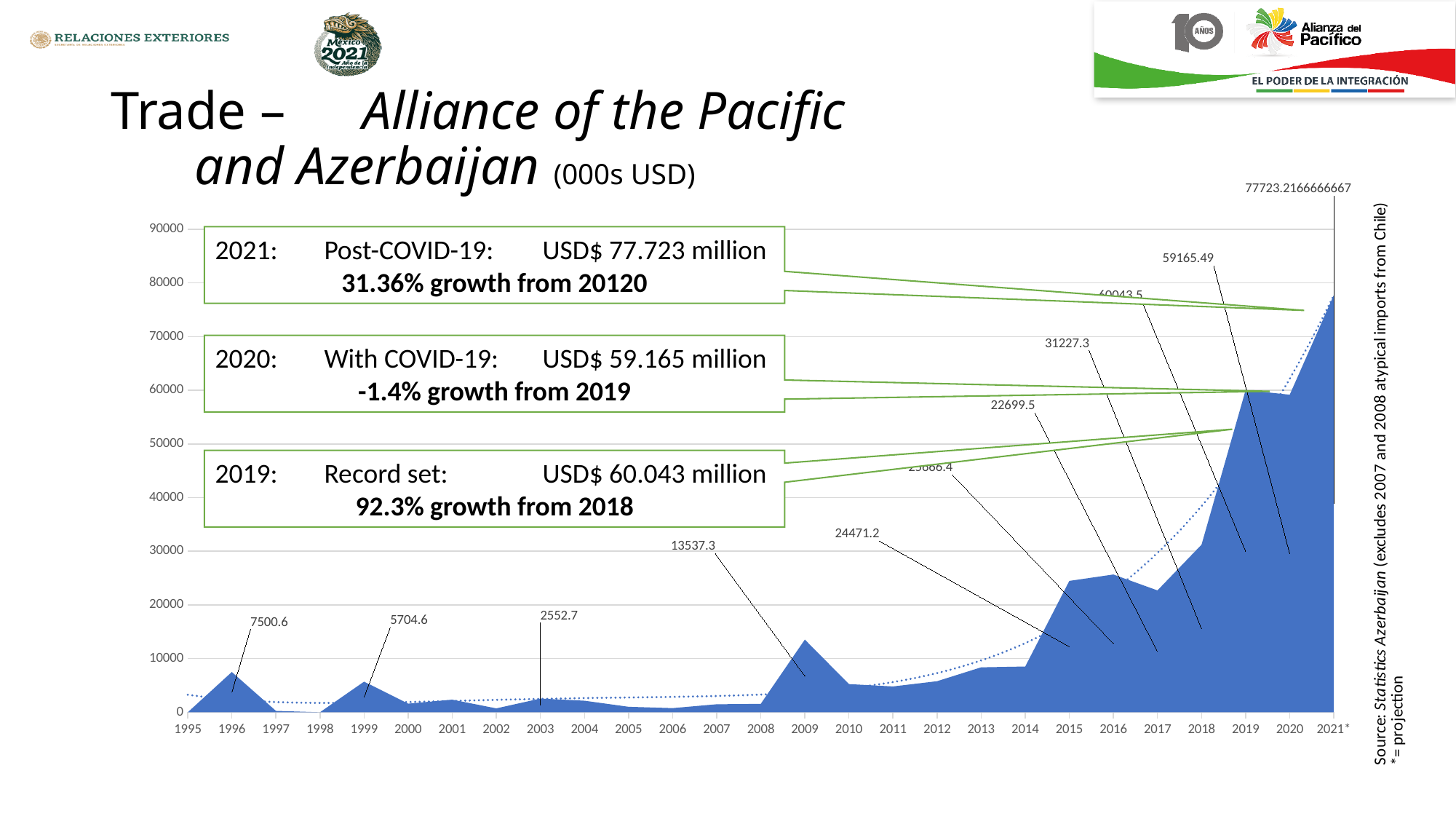
Do the values rise or fall from 2017 to 2021*? rise What kind of chart is shown on the slide? area chart What is the difference between the values for 2019 and 2018? 28816.2 What is the value plotted for 1996? 7500.6 What is the value plotted for 2020? 59165.49 What is the value plotted for 2019? 60043.5 Which is larger, the value for 2019 or the value for 2020? 2019 How many years are shown on the x axis? 27 What is the value plotted for 2009? 13537.3 Which year has the highest value on the chart? 2021* What is the value plotted for 2021*? 77723.2166666667 Is the value for 2014 greater or less than 10000? less